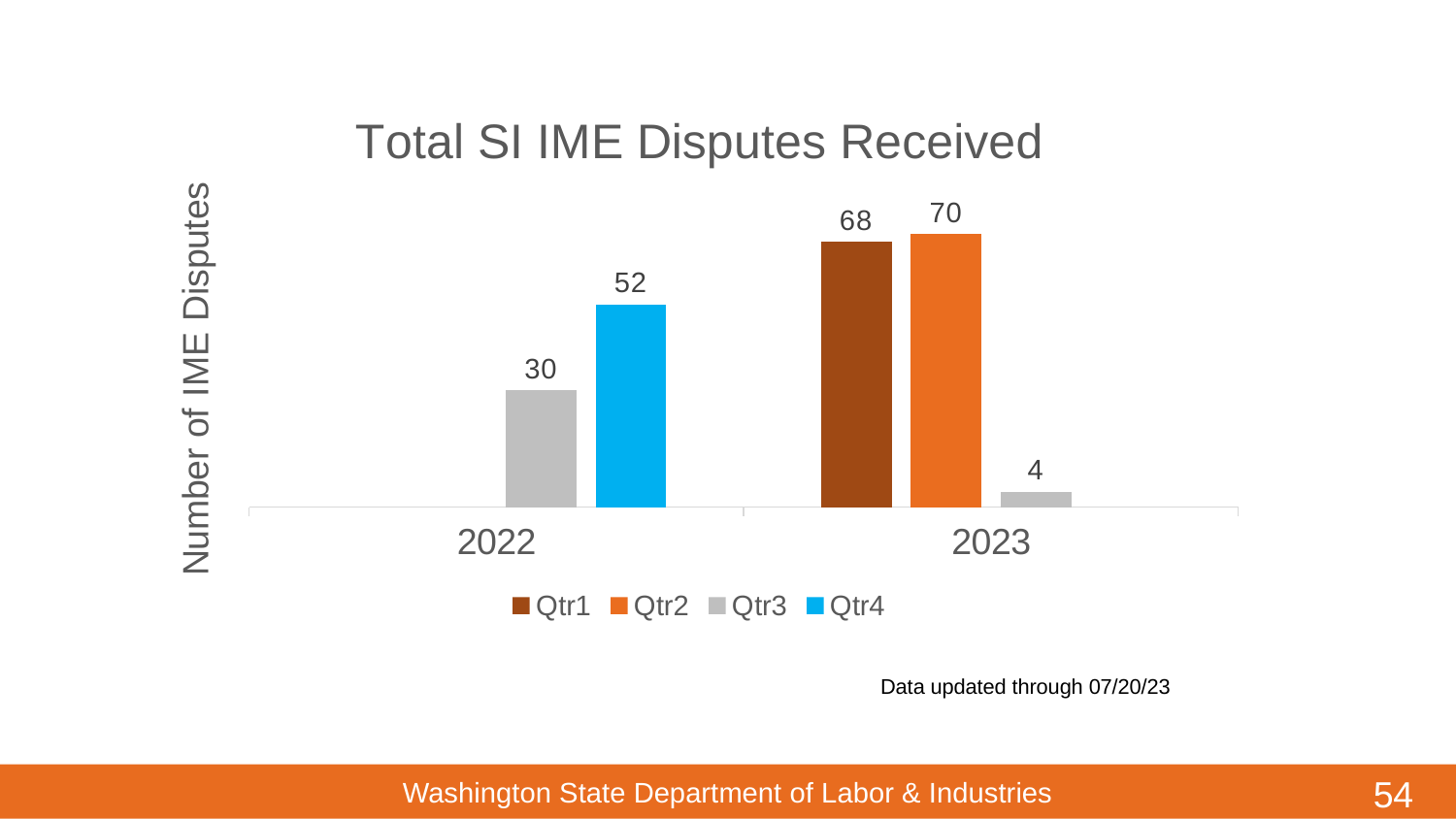
What is the value for Qtr1 in 2023? 68 What is the value for Qtr4 in 2022? 52 Which is larger: Qtr1 in 2023 or Qtr4 in 2022? Qtr1 in 2023 What is the value for Qtr3 in 2023? 4 What is the difference between Qtr4 and Qtr3 in 2022? 22 How many series does the legend list? 4 Which quarter has the lowest value in 2023? Qtr3 What kind of chart is shown? Bar chart What is the value for Qtr2 in 2023? 70 What is the title of the chart? Total SI IME Disputes Received What is the value for Qtr3 in 2022? 30 Which quarter has the highest value in 2023? Qtr2